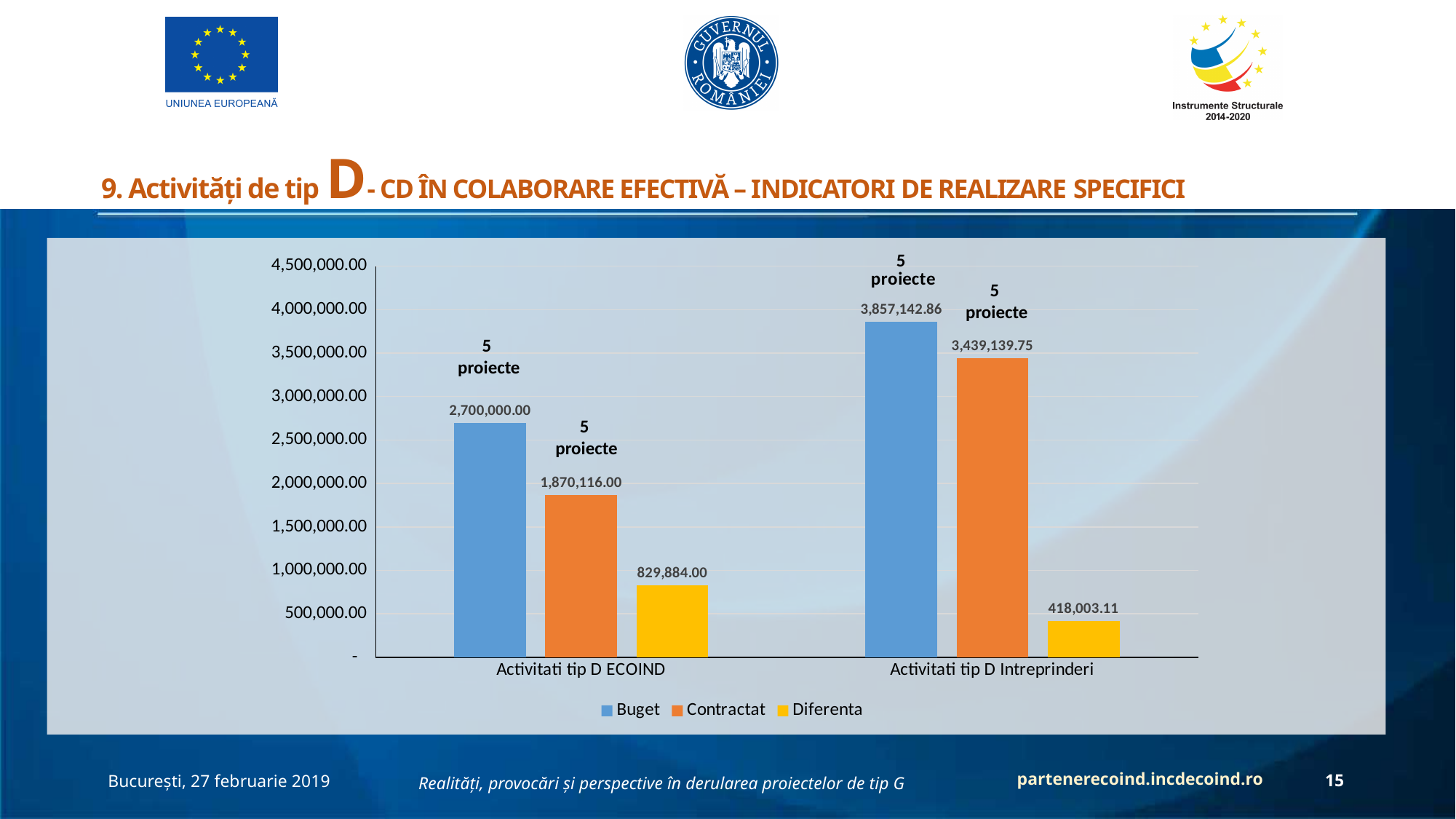
How many series does the legend list? 3 What is the Diferenta value for Activitati tip D ECOIND? 829,884.00 Which series has the lowest value for Activitati tip D Intreprinderi? Diferenta How many categories are shown on the x axis? 2 What is the Contractat value for Activitati tip D Intreprinderi? 3,439,139.75 What is the Buget value for Activitati tip D ECOIND? 2,700,000.00 Is the Contractat value for Activitati tip D ECOIND larger or smaller than the Contractat value for Activitati tip D Intreprinderi? smaller What is the Diferenta value for Activitati tip D Intreprinderi? 418,003.11 What is the difference between the Diferenta values for Activitati tip D ECOIND and Activitati tip D Intreprinderi? 411,880.89 Which category has the higher Buget value? Activitati tip D Intreprinderi What kind of chart is shown on the slide? bar chart What is the difference between the Buget values for Activitati tip D Intreprinderi and Activitati tip D ECOIND? 1,157,142.86